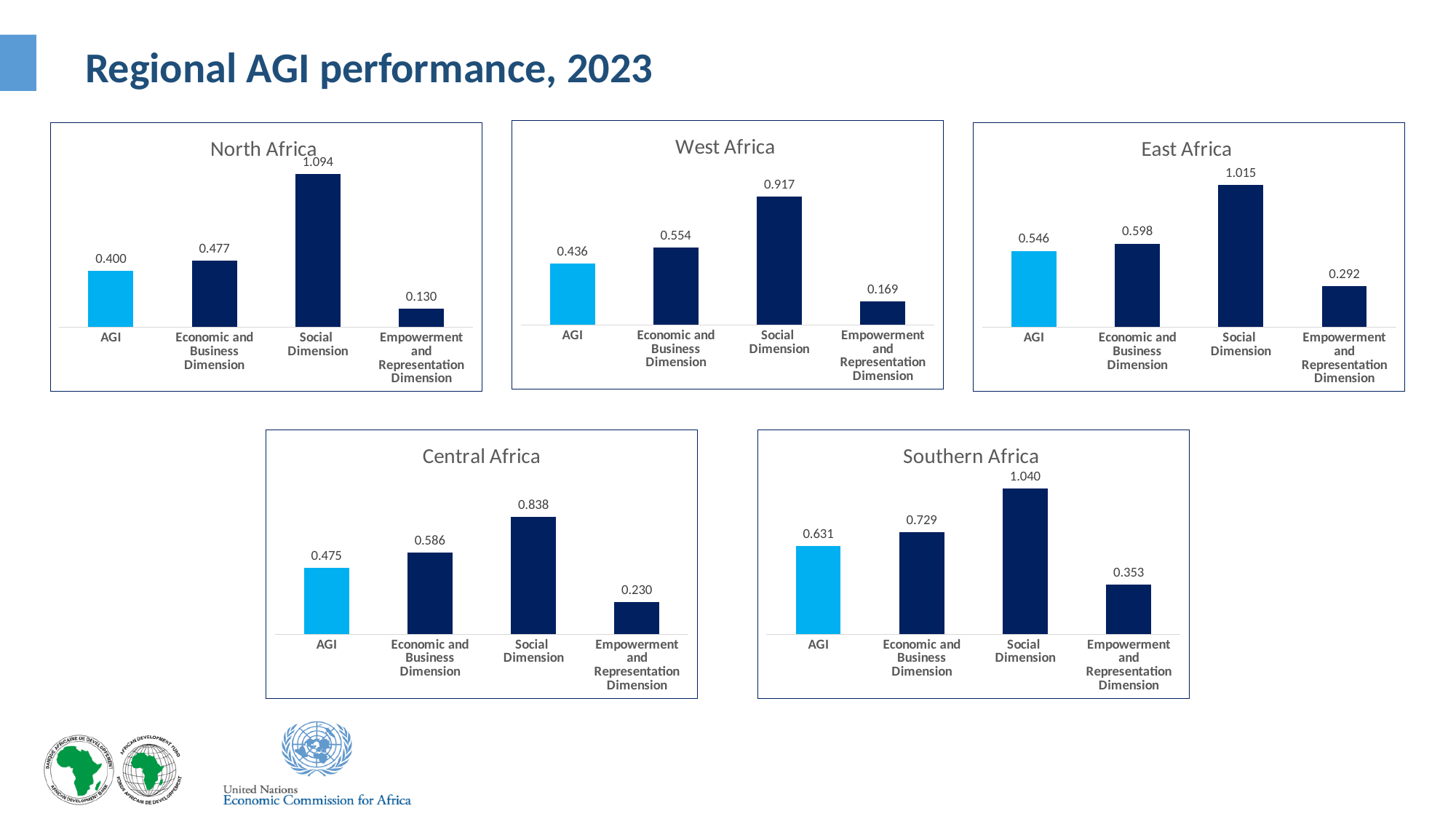
In the Central Africa chart, which category has the lowest value? Empowerment and Representation Dimension In the Central Africa chart, what is the value for the Economic and Business Dimension? 0.586 In the Southern Africa chart, which category has the highest value? Social Dimension In the East Africa chart, what is the value for the Empowerment and Representation Dimension? 0.292 In the North Africa chart, what is the value for the Social Dimension? 1.094 In the North Africa chart, what is the difference between the Economic and Business Dimension and AGI? 0.077 How many categories are shown in the Central Africa chart? 4 In the Southern Africa chart, what is the difference between the Social Dimension and the Economic and Business Dimension? 0.311 What type of chart is the East Africa chart? Bar chart In the West Africa chart, what is the value for AGI? 0.436 How many charts are shown on the slide? 5 In the West Africa chart, which is larger: the Economic and Business Dimension or the Empowerment and Representation Dimension? Economic and Business Dimension